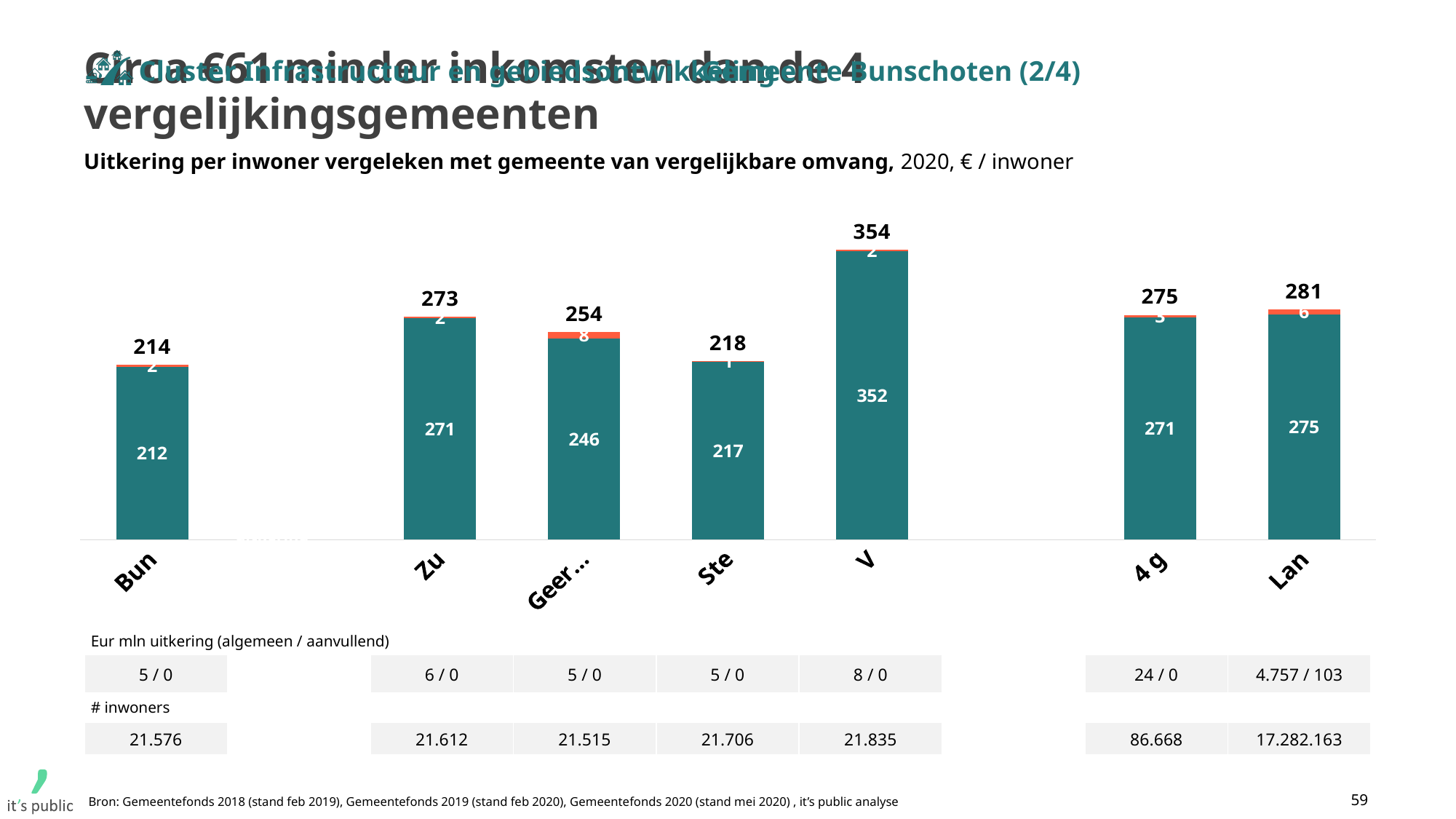
What is the total value shown above the bar for Bun? 214 What is the total of the stacked bar for Lan? 281 What kind of chart is shown on the slide? Bar chart What value is printed in the small orange segment on top of the bar for Geer…? 8 What is the difference between the total for Lan and the total for 4 g? 6 Which category has the lowest total value? Bun What value is printed inside the large teal segment of the bar for V? 352 In what unit are the values in the chart expressed, according to the chart subtitle? € / inwoner How many bars are shown in the chart? 7 Which has a larger total, Zu or Lan? Lan Which category has the highest total value? V What is the difference between the total for V and the total for Bun? 140